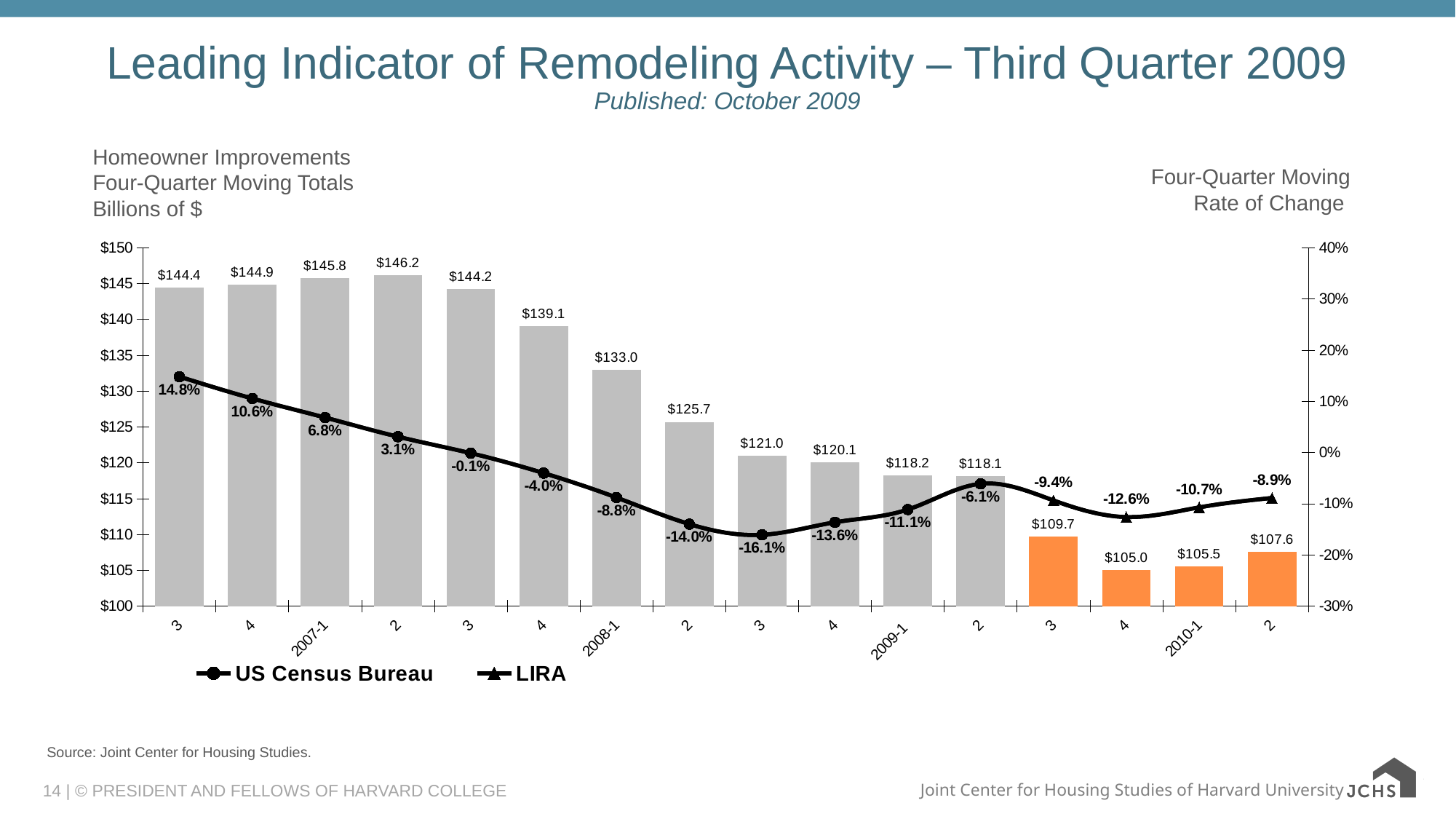
What is the four-quarter moving total for 2010-1? $105.5 What is the four-quarter moving total for 2007-1? $145.8 Which is larger, the four-quarter moving total for 2007-1 or for 2008-1? 2007-1 What is the lowest four-quarter moving rate of change shown on the chart? -16.1% What is the four-quarter moving rate of change for 2008-1? -8.8% How many series does the legend list? 2 Which series does the legend show with triangle markers? LIRA What is the four-quarter moving rate of change for 2009-1? -11.1% What is the difference between the four-quarter moving totals for 2008-1 and 2009-1? $14.8 Which quarter has the lowest four-quarter moving total? 2009 Q4 ($105.0) Which quarter has the highest four-quarter moving total? 2007 Q2 ($146.2) How many bars are plotted on the chart? 16